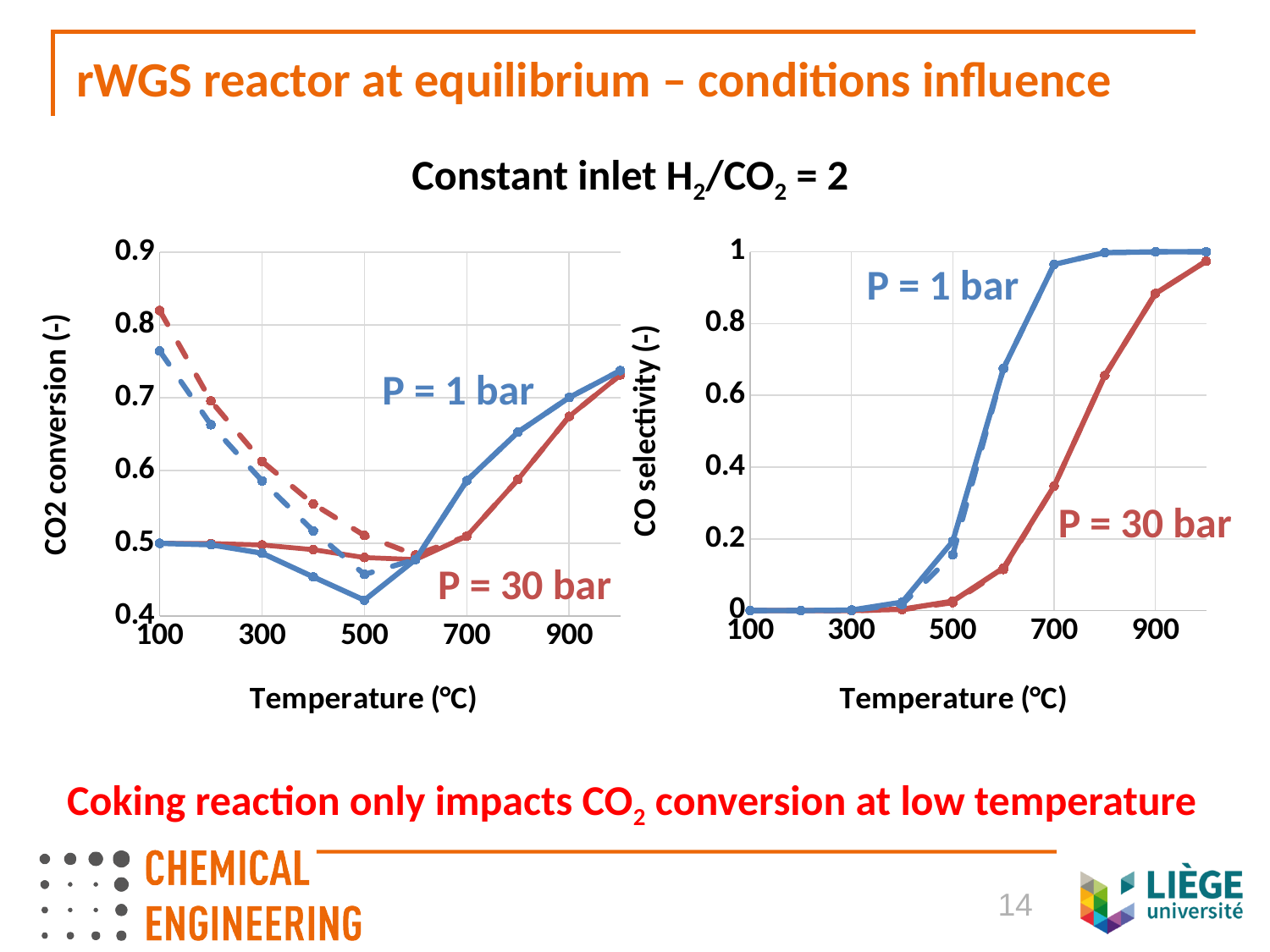
How many temperature values are labelled on the x axis of the right chart? 5 In the right chart (CO selectivity), is the value for P = 30 bar at 600 °C greater or less than 0.2? less What is the y-axis label of the left chart? CO2 conversion (-) In the right chart (CO selectivity), is the value for P = 1 bar at 700 °C greater or less than 0.8? greater In the left chart (CO2 conversion), is the dashed red P = 30 bar value at 100 °C greater or less than 0.8? greater In the right chart (CO selectivity), which pressure has the higher CO selectivity at 700 °C, P = 1 bar or P = 30 bar? P = 1 bar In the right chart (CO selectivity), does the P = 1 bar curve rise or fall as temperature increases? rise What kind of chart is the left chart (CO2 conversion vs temperature)? line chart In the left chart (CO2 conversion), does the solid P = 1 bar curve rise or fall between 500 °C and 1000 °C? rise In the left chart (CO2 conversion), which solid curve is higher at 500 °C, P = 1 bar or P = 30 bar? P = 30 bar